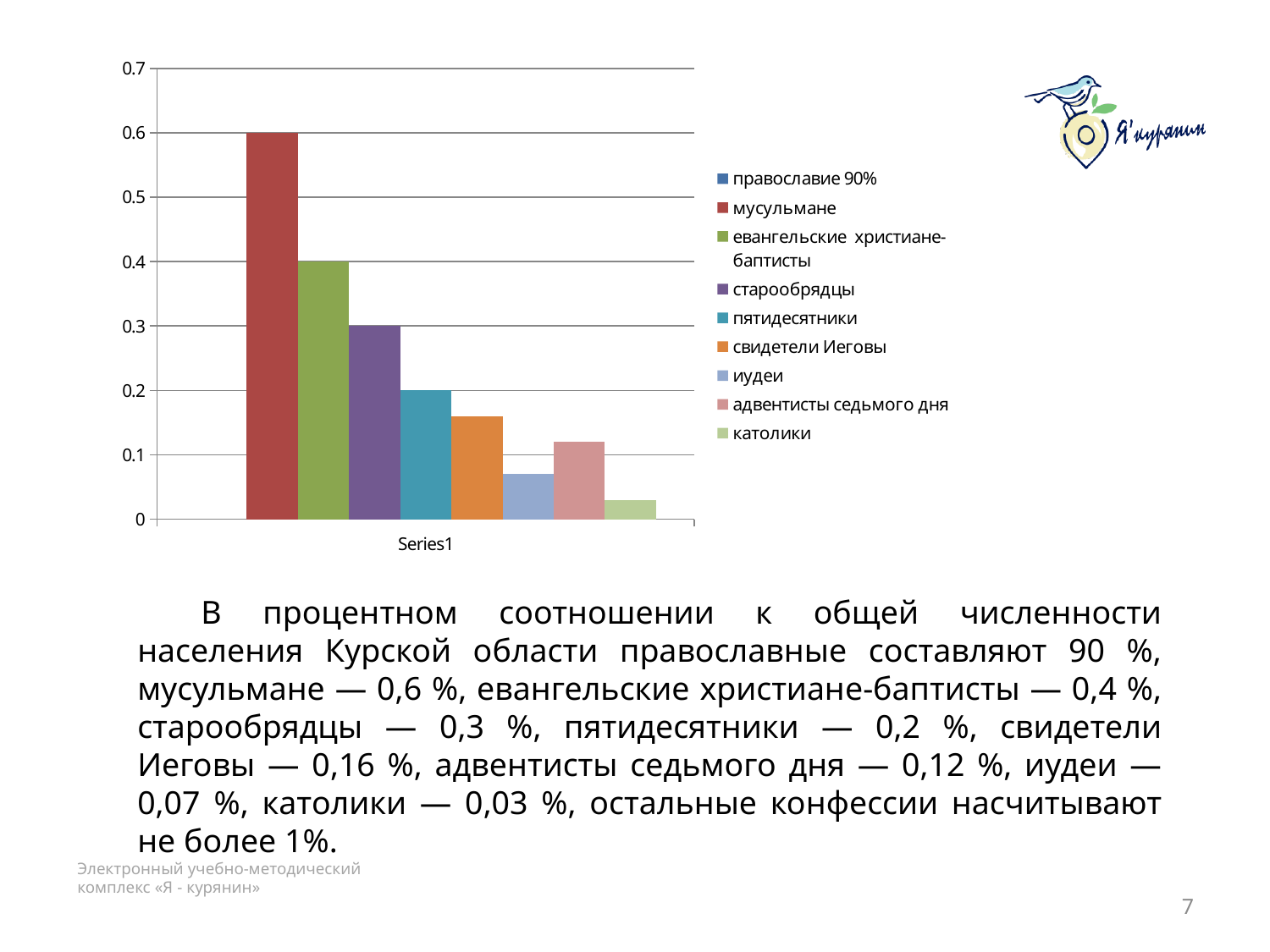
What kind of chart is shown on the slide? bar chart Which category has the shortest bar in the chart? католики What is the value of the bar for пятидесятники? 0.2 What is the value of the bar for старообрядцы? 0.3 Which bar is taller: свидетели Иеговы or адвентисты седьмого дня? свидетели Иеговы Do the bar heights rise or fall from left to right across the chart? fall Is the value for иудеи greater or less than 0.1? less Which category has the tallest bar in the chart? мусульмане What is the value of the bar for мусульмане? 0.6 How many entries does the chart legend list? 9 What is the value of the bar for евангельские христиане-баптисты? 0.4 What is the difference between the bars for мусульмане and старообрядцы? 0.3